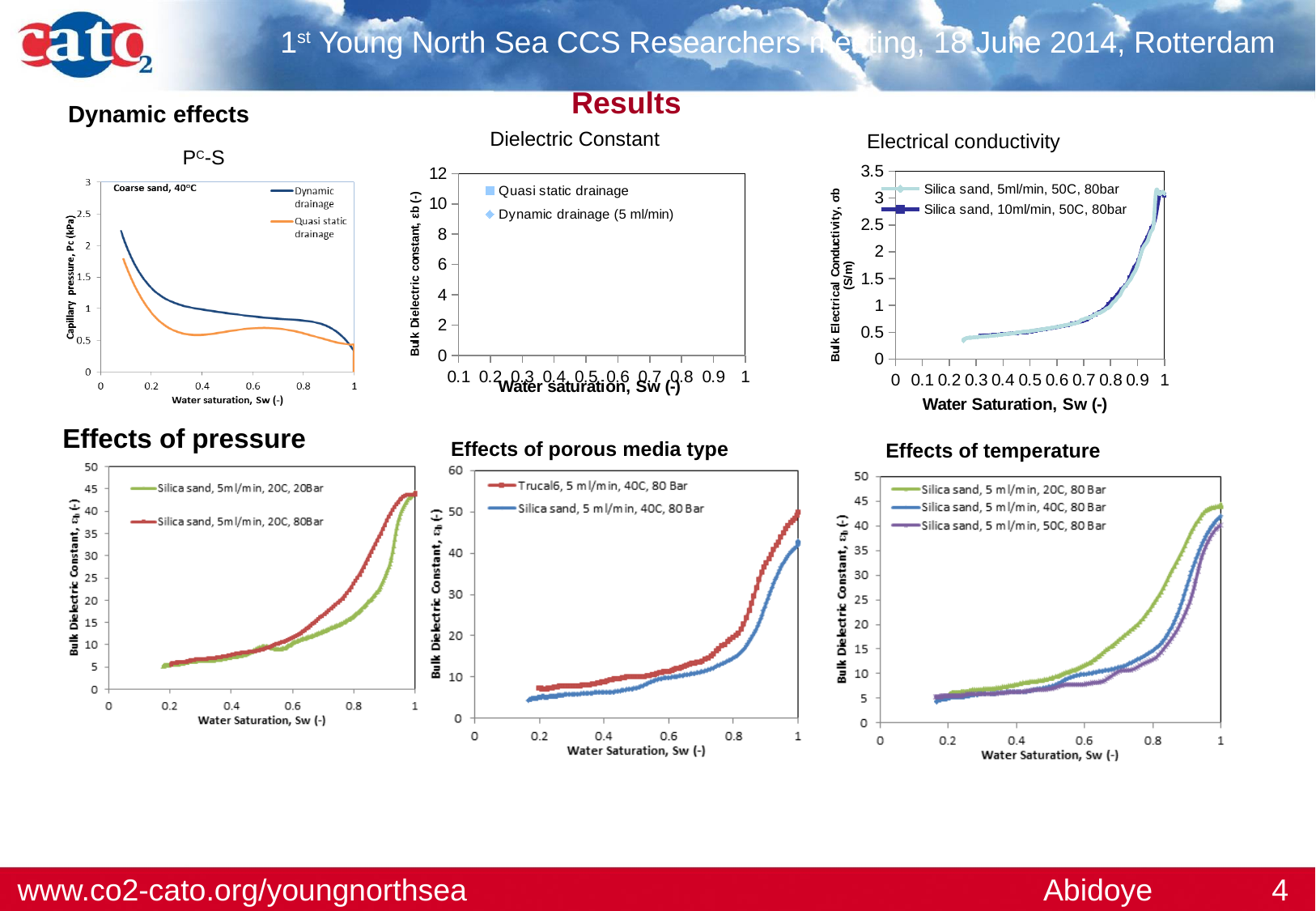
In the 'Pc-S' chart, is the Quasi static drainage value at the lowest water saturation greater or less than 2? less In the 'Effects of porous media type' chart, how many series does the legend list? 2 In the 'Electrical conductivity' chart, is the value at water saturation 1 greater or less than 2? greater In the 'Effects of porous media type' chart, is the Trucal6 value at water saturation 1 greater or less than 40? greater In the 'Effects of pressure' chart, which series has the higher bulk dielectric constant at water saturation 0.8, the 20Bar or the 80Bar series? 80Bar In the 'Effects of porous media type' chart, which series has the higher bulk dielectric constant at water saturation 0.8, Trucal6 or Silica sand? Trucal6 In the 'Effects of temperature' chart, how many series does the legend list? 3 What is the x-axis label of the 'Effects of temperature' chart? Water Saturation, Sw (-) In the 'Electrical conductivity' chart, do the values rise or fall as water saturation increases? Rise What are the two legend entries in the 'Dielectric Constant' chart? Quasi static drainage; Dynamic drainage (5 ml/min) In the 'Pc-S' chart, does the Dynamic drainage curve rise or fall as water saturation increases? Fall What kind of chart is the 'Electrical conductivity' chart? Line chart